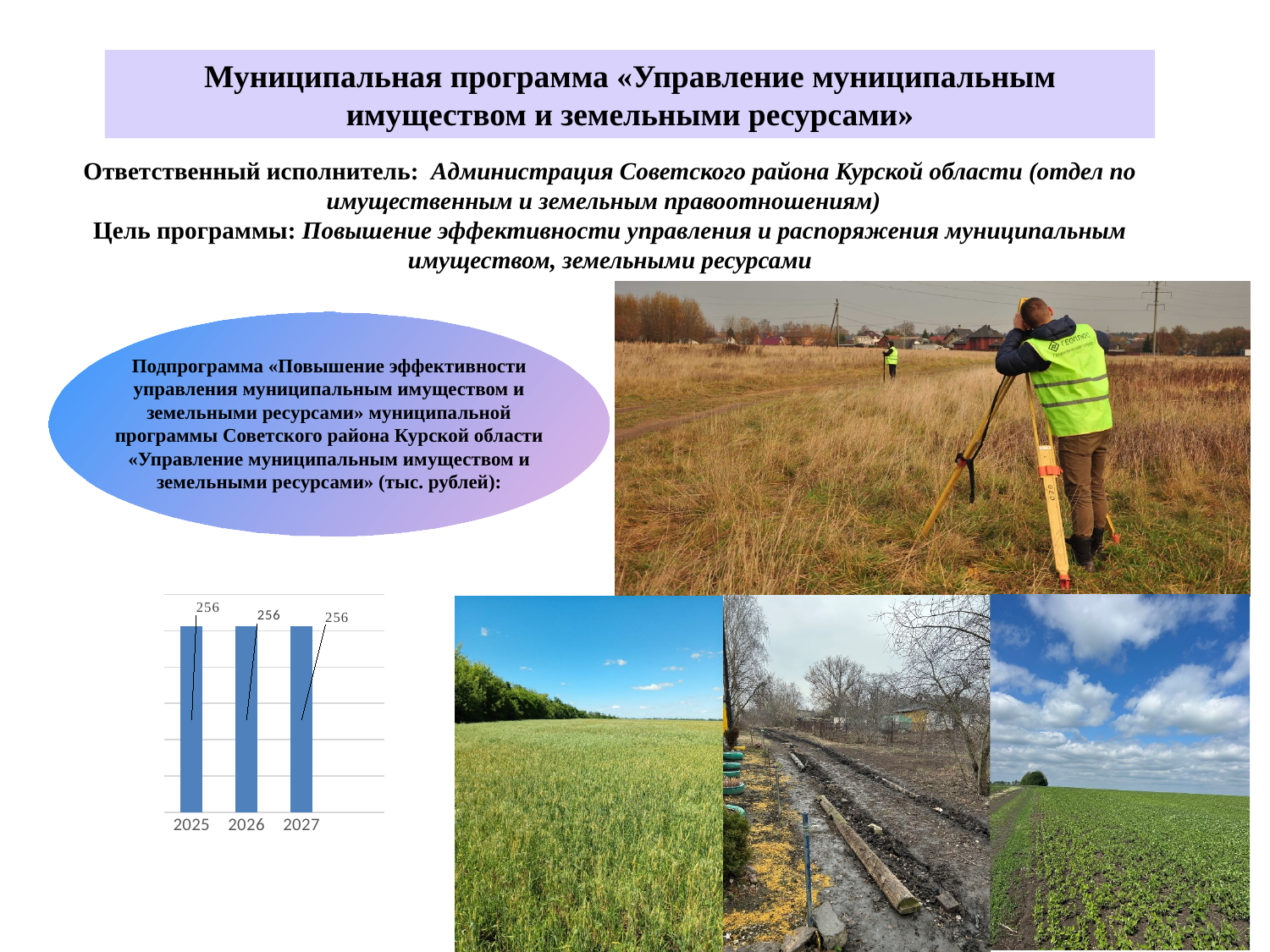
Which year is the first category on the x axis of the bar chart? 2025 What colour are the bars in the bar chart? blue What is the value for 2027 in the bar chart? 256 How many categories (years) are shown in the bar chart? 3 What is the difference between the values for 2027 and 2025 in the bar chart? 0 What is the difference between the values for 2026 and 2025 in the bar chart? 0 What is the value for 2026 in the bar chart? 256 Do the values in the bar chart rise, fall, or stay the same from 2025 to 2027? stay the same What is the value for 2025 in the bar chart? 256 What kind of chart is shown on the slide? bar chart